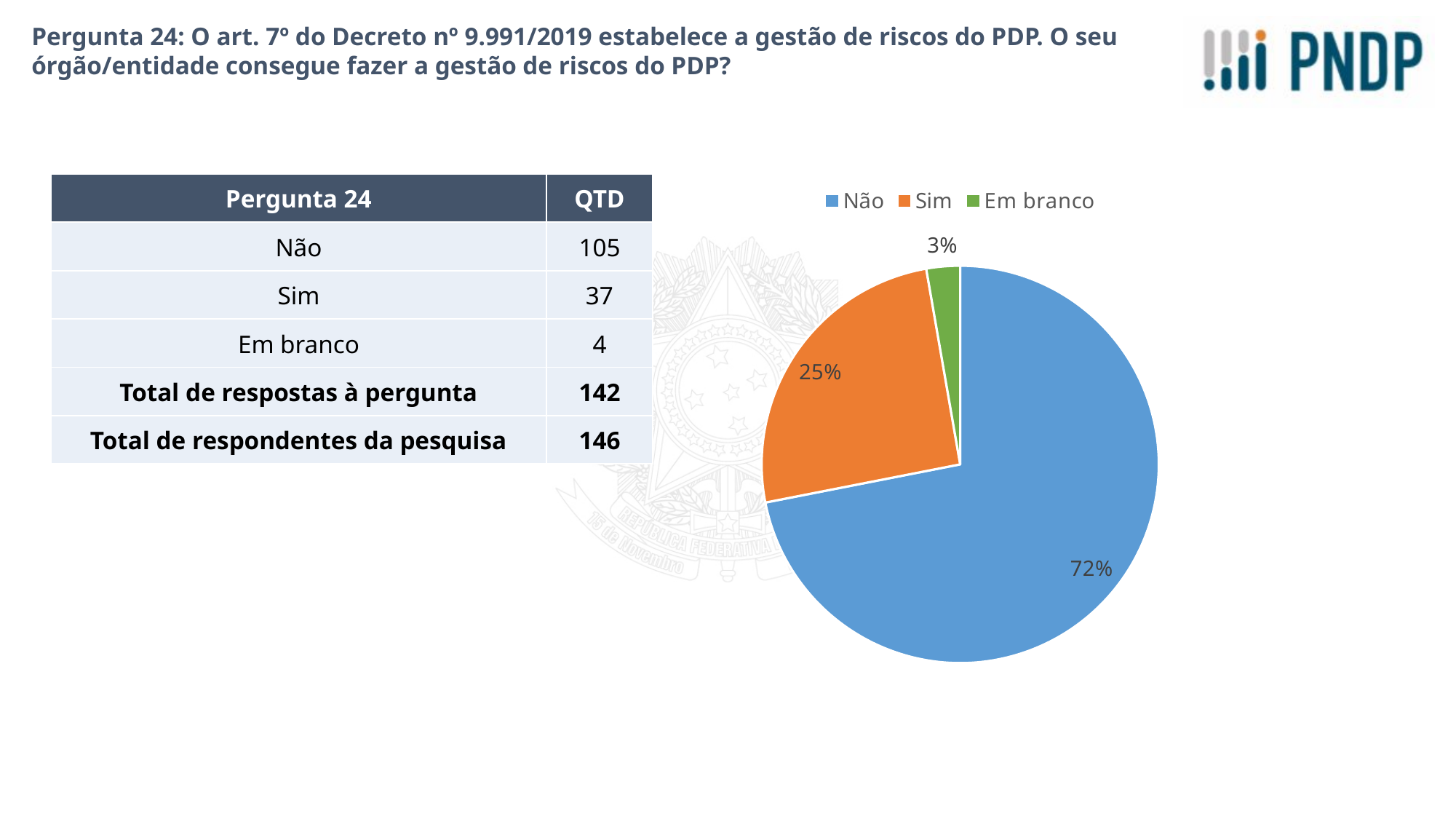
What is the difference in percentage points between the "Não" slice and the "Sim" slice? 47% How many slices does the pie chart have? 3 What kind of chart is shown on the slide? pie chart Which category is shown in green in the pie chart? Em branco Which category has the largest slice of the pie? Não Which slice is larger, "Sim" or "Em branco"? Sim What colour is the "Sim" slice in the pie chart? orange What share of the pie does the "Não" slice represent? 72% Which category has the smallest slice of the pie? Em branco What share of the pie does the "Em branco" slice represent? 3% What share of the pie does the "Sim" slice represent? 25% How many entries does the legend list? 3